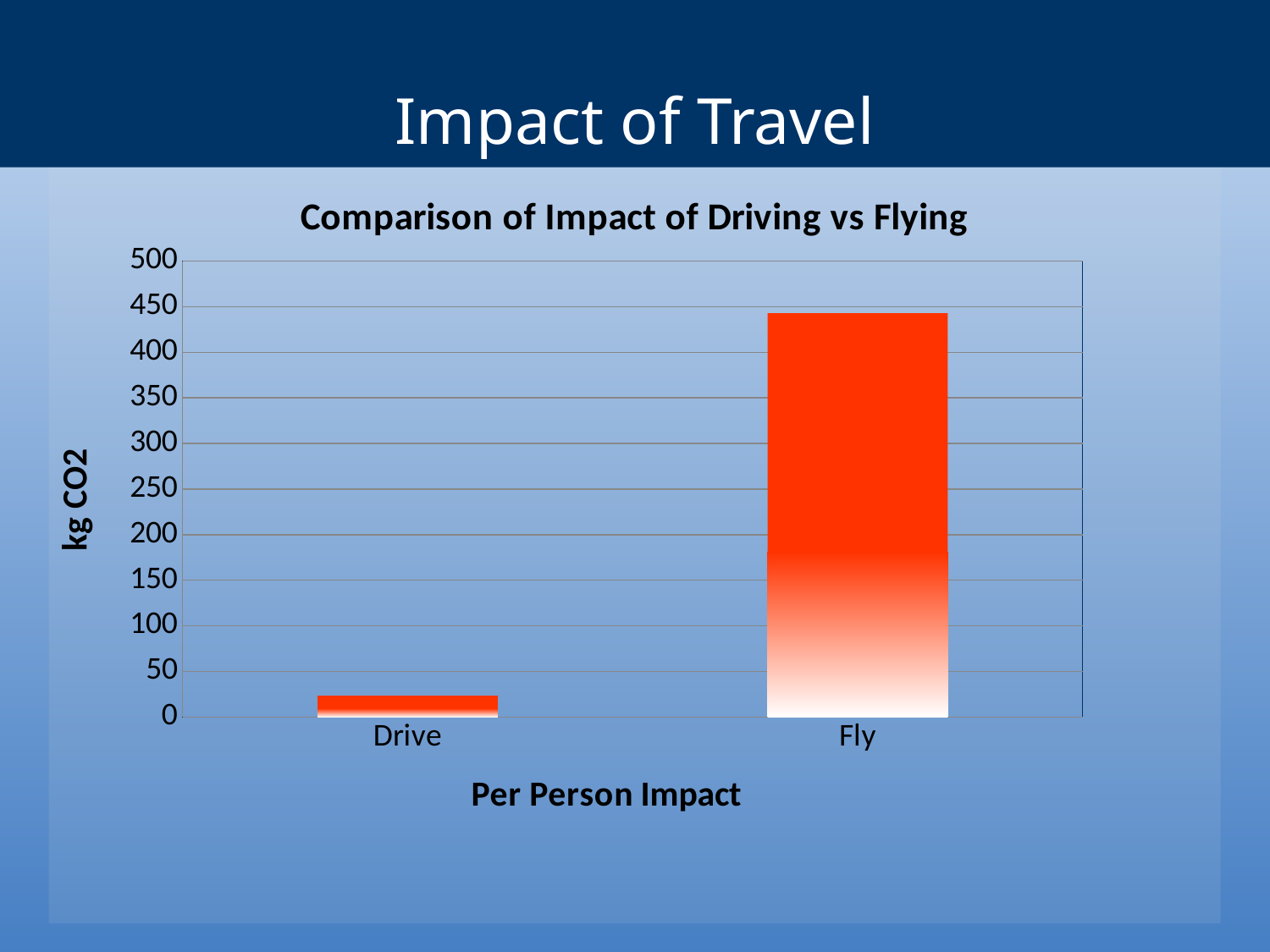
What is the title of the chart? Comparison of Impact of Driving vs Flying Which is larger, the value for Drive or the value for Fly? Fly Is the value for Fly greater or less than 400? greater Which category has the highest value? Fly Do the values rise or fall from Drive to Fly along the x axis? rise What kind of chart is shown on the slide? bar chart How many categories are plotted on the chart? 2 Is the value for Drive greater or less than 50? less Which category has the lowest value? Drive Is the value for Fly greater or less than 450? less What is the label of the vertical axis? kg CO2